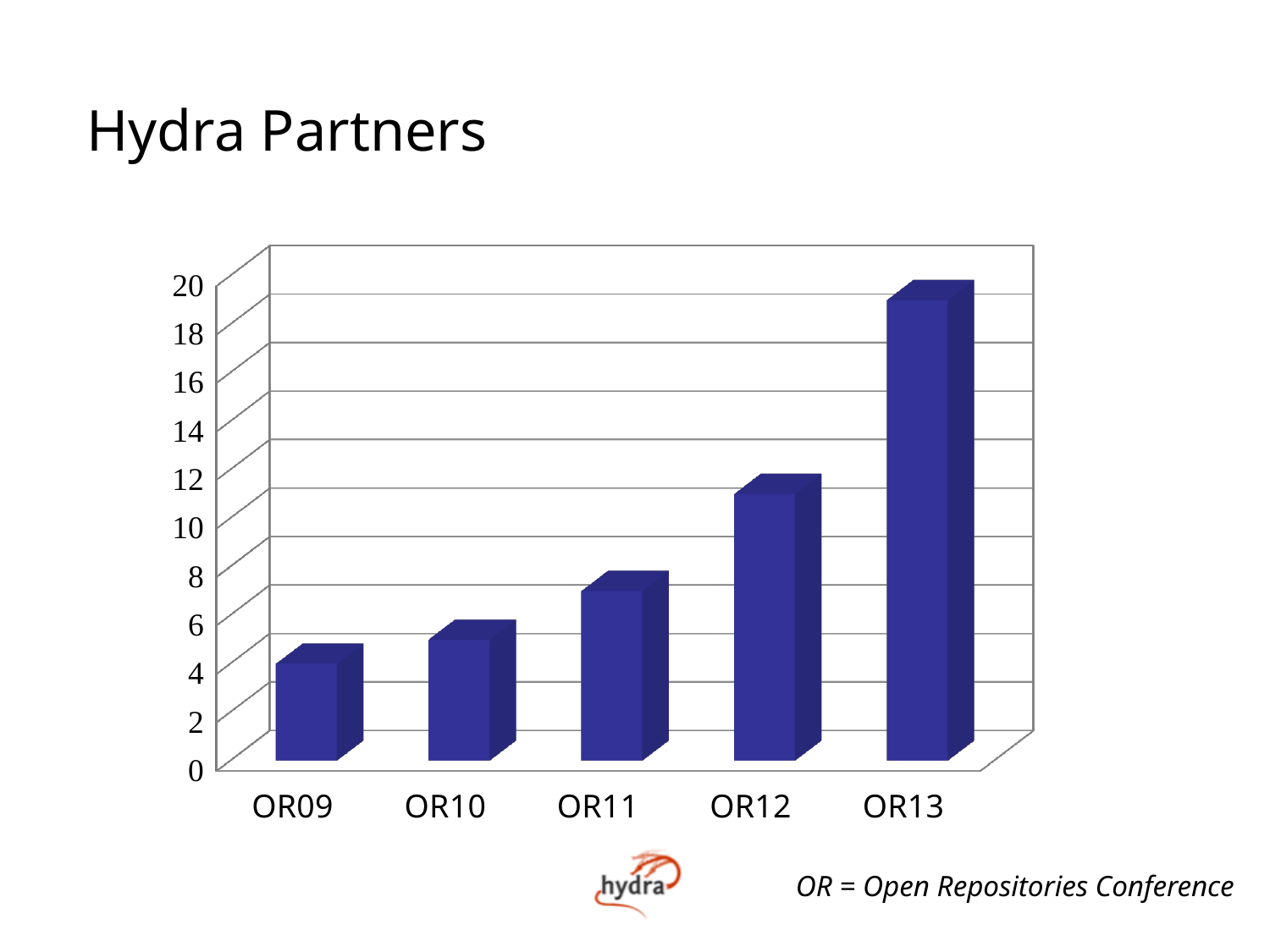
Which is larger, the value for OR09 or the value for OR13? OR13 Is the value for OR12 greater or less than 10? greater According to the note on the slide, what does OR stand for? Open Repositories Conference What kind of chart is shown on the slide? bar chart What is the title of the chart on the slide? Hydra Partners Do the values rise or fall from OR09 to OR13? rise Which category has the lowest value in the chart? OR09 Which category has the highest value in the chart? OR13 Is the value for OR09 greater or less than 6? less How many categories are shown on the x axis of the chart? 5 Is the value for OR13 greater or less than 16? greater Which is larger, the value for OR12 or the value for OR11? OR12